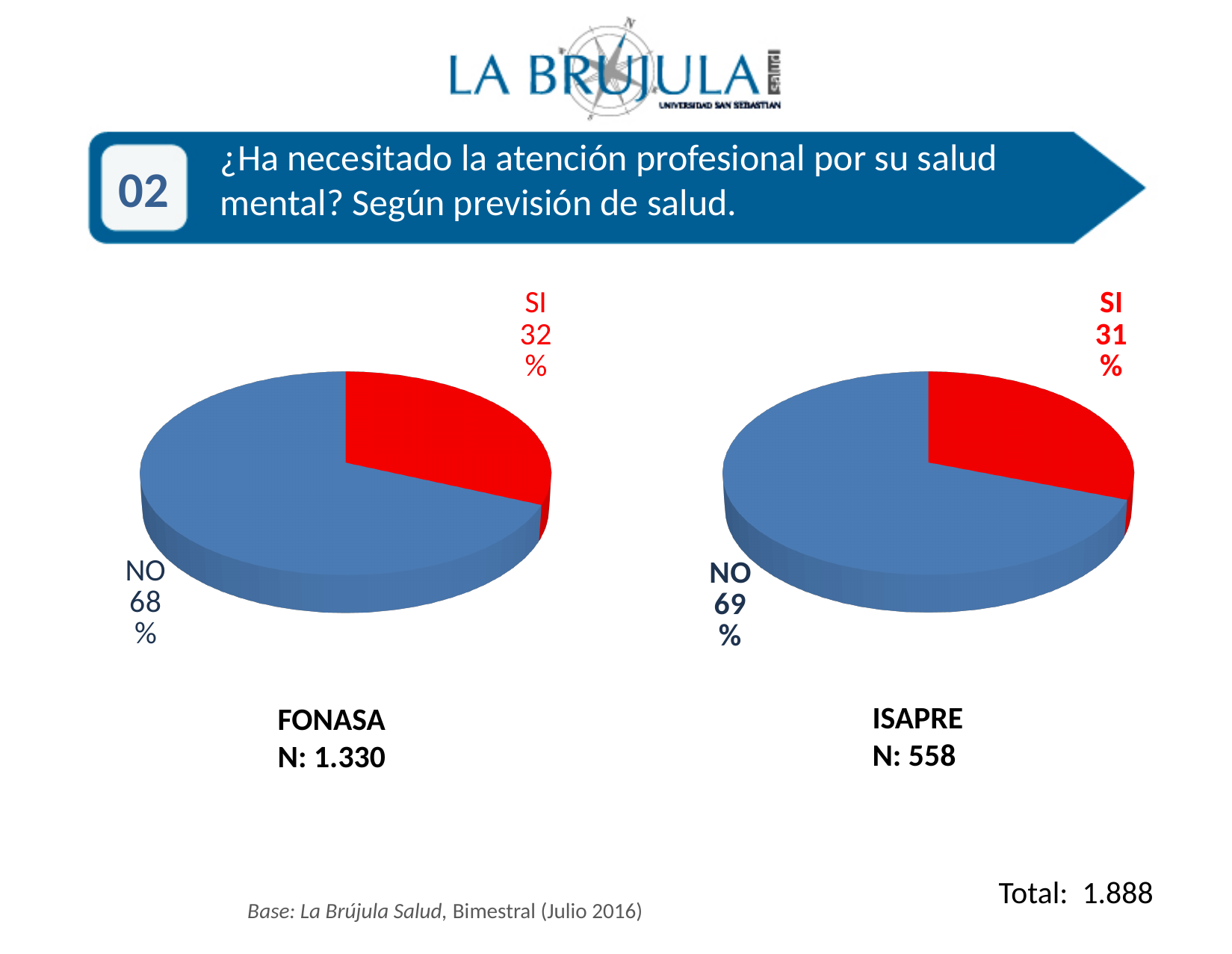
Which is larger: the SI share in the FONASA chart or the SI share in the ISAPRE chart? FONASA In the FONASA pie chart, which slice is the largest? NO In the FONASA pie chart, what percentage answered SI? 32% What is the N (sample size) shown under the ISAPRE pie chart? 558 What type of chart is used for the ISAPRE data? Pie chart What colour is the SI slice in the FONASA pie chart? Red In the ISAPRE pie chart, what percentage answered NO? 69% In the ISAPRE pie chart, what percentage answered SI? 31% How many slices does the FONASA pie chart have? 2 In the FONASA pie chart, what percentage answered NO? 68% In the ISAPRE pie chart, which slice is the smallest? SI In the FONASA pie chart, what is the difference between the NO and SI percentages? 36%